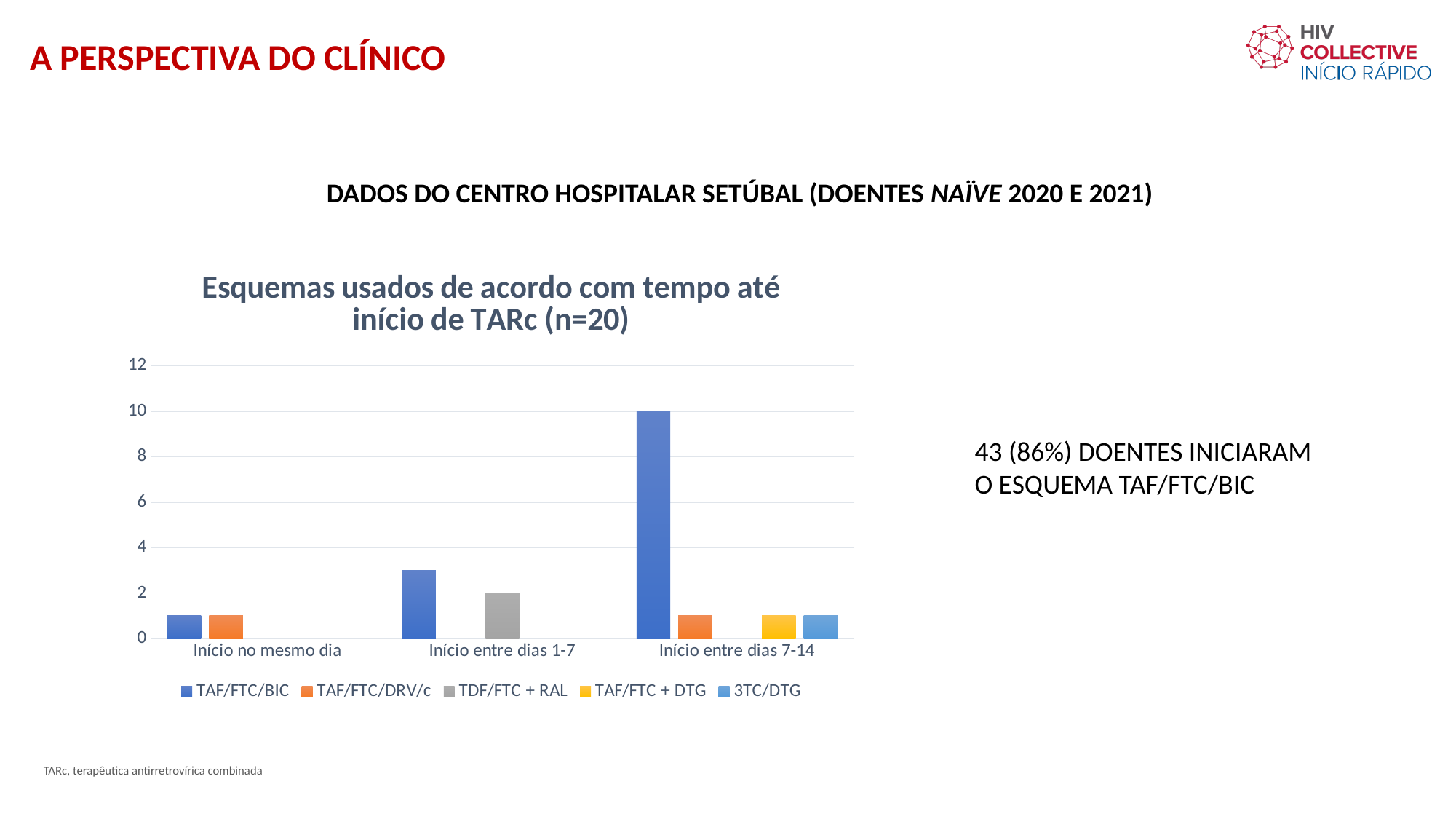
How many categories are shown on the x axis? 3 What is the title of the chart? Esquemas usados de acordo com tempo até início de TARc (n=20) Is the value for TAF/FTC/BIC in 'Início entre dias 1-7' greater or less than 2? greater What kind of chart is shown on the slide? bar chart What is the value for TAF/FTC/BIC in the 'Início entre dias 7-14' category? 10 Which is larger in 'Início entre dias 1-7': TAF/FTC/BIC or TDF/FTC + RAL? TAF/FTC/BIC Which category has the lowest TAF/FTC/BIC bar? Início no mesmo dia Is the value for TAF/FTC/DRV/c in 'Início no mesmo dia' greater or less than 2? less What is the value for TDF/FTC + RAL in the 'Início entre dias 1-7' category? 2 Which category has the highest TAF/FTC/BIC bar? Início entre dias 7-14 Does the TAF/FTC/BIC series rise or fall across the categories from left to right? rise How many series does the legend list? 5